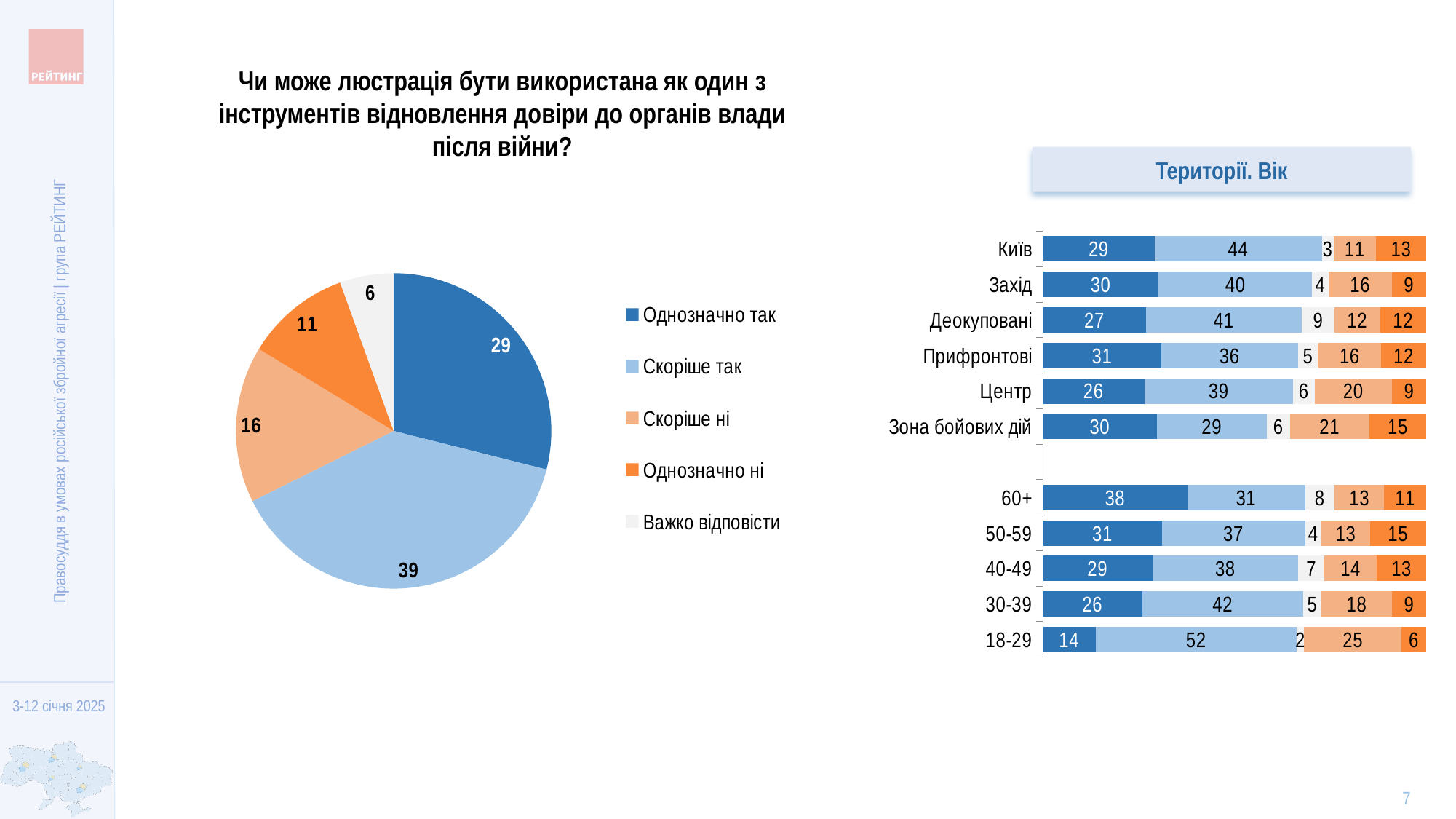
In the "Території. Вік" chart, which category has the lowest value for the dark blue "Однозначно так" segment? 18-29 What kind of chart is the chart on the left of the slide? Pie chart How many categories (bars) are shown in the "Території. Вік" chart? 11 In the pie chart, which category has the smallest slice? Важко відповісти How many entries does the legend of the pie chart list? 5 In the "Території. Вік" chart, what is the value of the dark blue "Однозначно так" segment for "60+"? 38 In the "Території. Вік" chart, what is the total of the stacked bar for "Центр"? 100 In the pie chart, what is the difference between the values for "Однозначно так" and "Однозначно ні"? 18 In the "Території. Вік" chart, what is the value of the light blue "Скоріше так" segment for "18-29"? 52 In the pie chart, what is the value for "Скоріше так"? 39 In the "Території. Вік" chart, which category has the highest value for the dark blue "Однозначно так" segment? 60+ In the "Території. Вік" chart, is the "Скоріше так" value larger for "Київ" or for "Зона бойових дій"? Київ